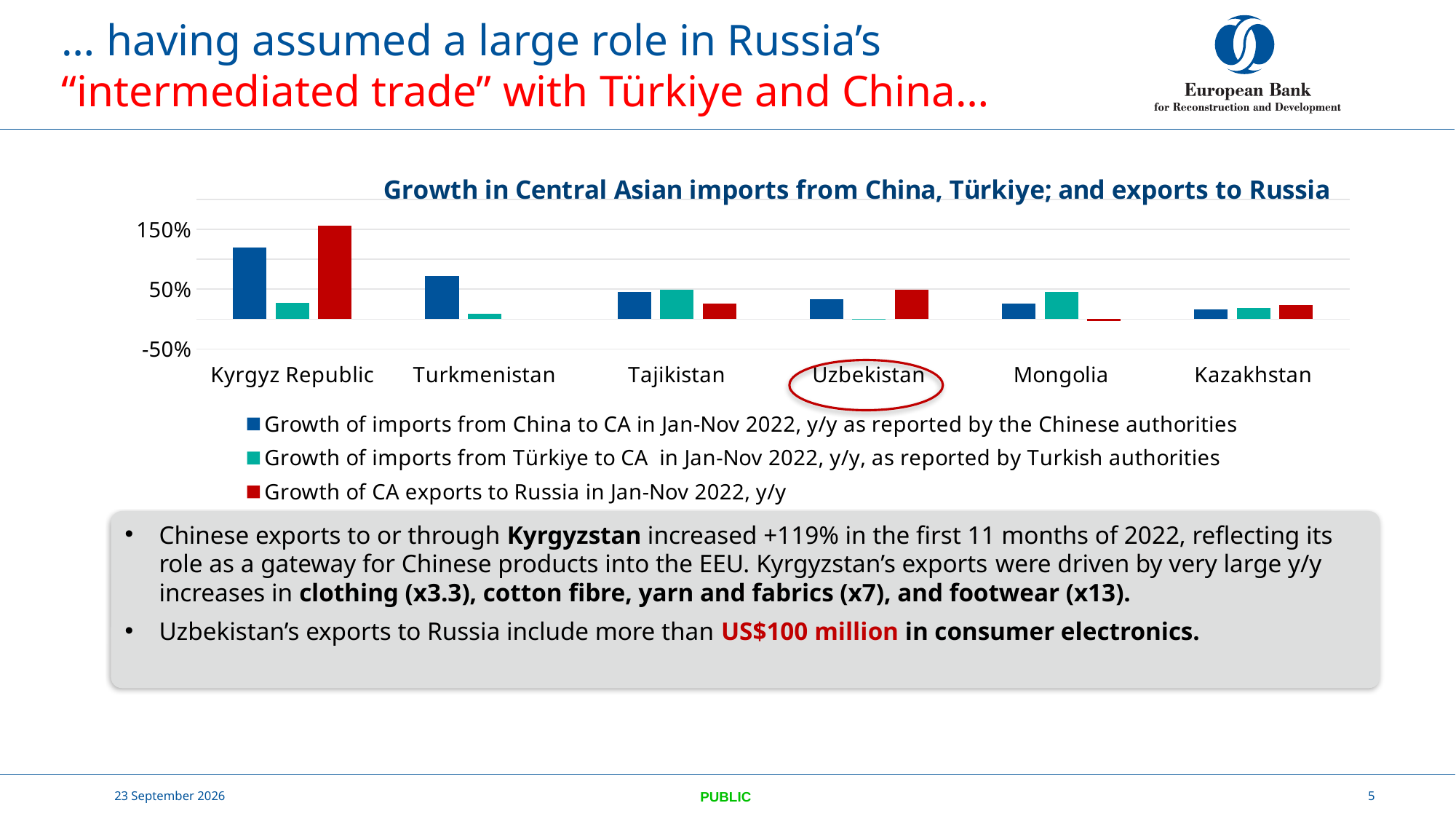
Which is larger: growth of imports from China to CA for the Kyrgyz Republic or for Turkmenistan? Kyrgyz Republic For Mongolia, which is larger: growth of imports from Türkiye to CA or growth of imports from China to CA? Growth of imports from Türkiye to CA Which country has the highest growth of imports from China to CA in Jan-Nov 2022? Kyrgyz Republic How many countries are shown on the x axis of the chart? 6 How many series does the chart's legend list? 3 What kind of chart is shown on the slide? bar chart Is the growth of imports from China to CA for Turkmenistan greater or less than 50%? greater Which country has the highest growth of CA exports to Russia in Jan-Nov 2022? Kyrgyz Republic Is the growth of imports from China to CA for the Kyrgyz Republic greater or less than 50%? greater What is the title of the chart? Growth in Central Asian imports from China, Türkiye; and exports to Russia Is the growth of imports from China to CA for Kazakhstan greater or less than 50%? less Which country has the lowest growth of imports from China to CA in Jan-Nov 2022? Kazakhstan